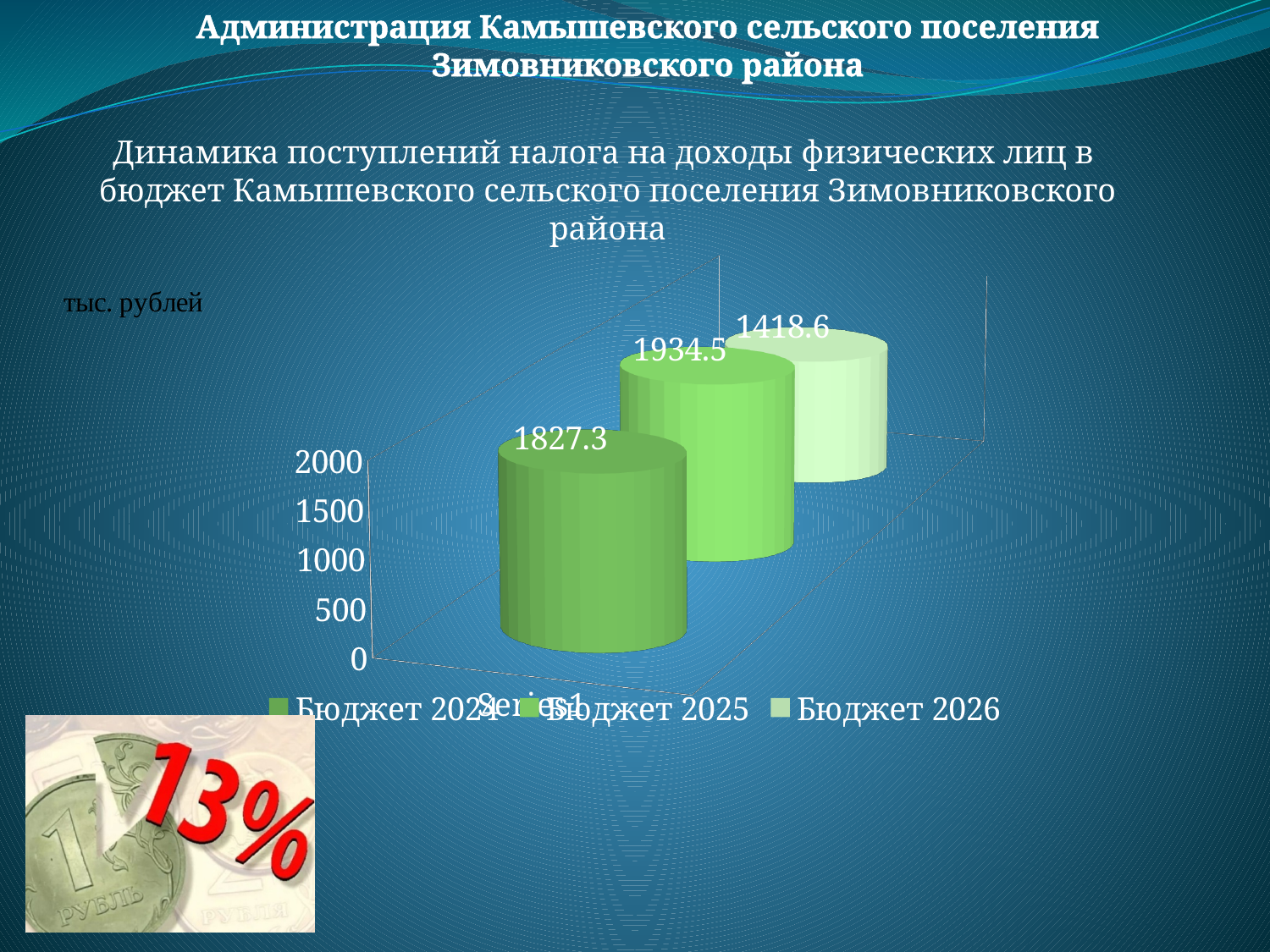
What unit of measurement is indicated for the chart values? тыс. рублей What value is shown for Бюджет 2024? 1827.3 What value is shown for Бюджет 2026? 1418.6 What kind of chart is shown on the slide? bar chart Which budget year has the lowest value? Бюджет 2026 How many series does the legend list? 3 Which is larger, the value for Бюджет 2024 or Бюджет 2026? Бюджет 2024 Which budget year has the highest value? Бюджет 2025 Is the value for Бюджет 2026 greater or less than 1500? less What is the difference between the values for Бюджет 2024 and Бюджет 2026? 408.7 What is the difference between the values for Бюджет 2025 and Бюджет 2024? 107.2 What value is shown for Бюджет 2025? 1934.5